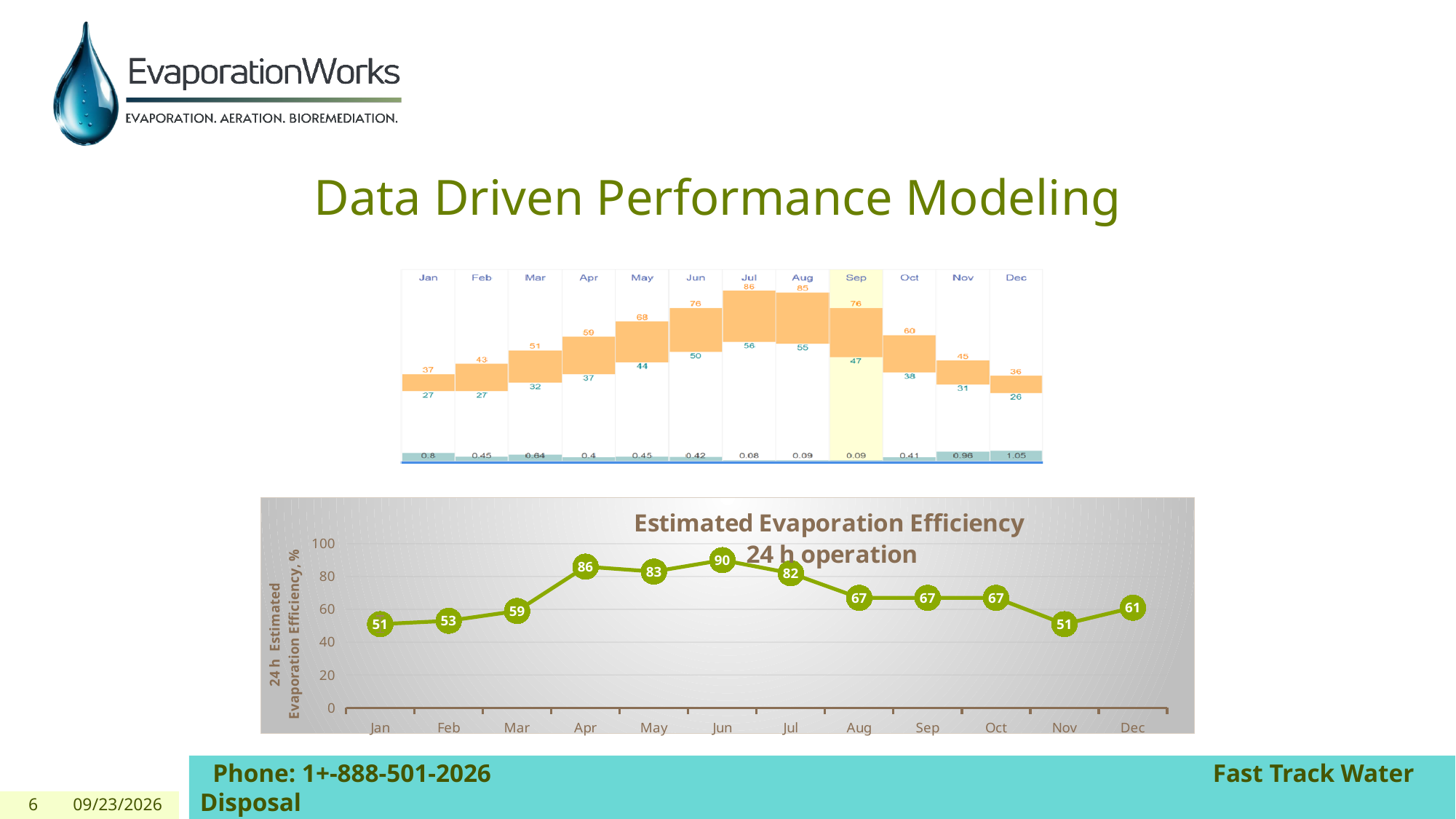
In the Estimated Evaporation Efficiency chart, which months share the value 67? Aug, Sep, Oct In the Estimated Evaporation Efficiency chart, which month has the highest value? Jun What kind of chart is the Estimated Evaporation Efficiency chart? line chart In the Estimated Evaporation Efficiency chart, how many months are plotted on the x axis? 12 In the top chart, what is the upper value shown for Jul? 86 In the Estimated Evaporation Efficiency chart, what is the value for Mar? 59 In the Estimated Evaporation Efficiency chart, do the values rise or fall from Jan to Apr? rise In the Estimated Evaporation Efficiency chart, which is larger, the value for May or the value for Jul? May In the top chart, what is the value shown in the bottom row for Dec? 1.05 In the Estimated Evaporation Efficiency chart, what is the difference between the values for Apr and Mar? 27 In the Estimated Evaporation Efficiency chart, what is the value for Jun? 90 What is the y-axis label of the Estimated Evaporation Efficiency chart? 24 h Estimated Evaporation Efficiency, %